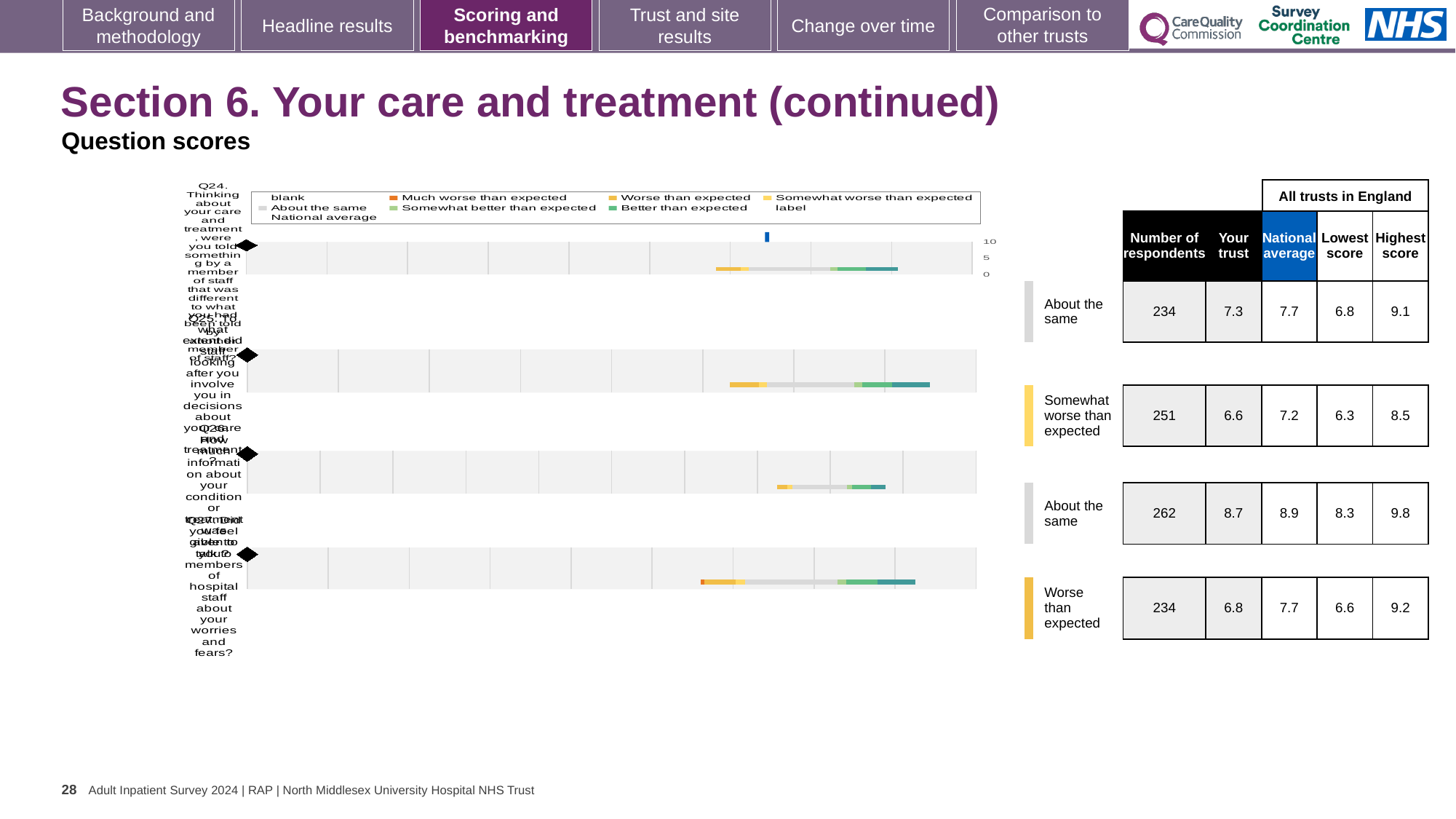
For the fourth question row (Q27), what is the highest score among all trusts in England? 9.2 Which legend entry is shown in dark orange? Much worse than expected What kind of chart is used to show the question scores on this slide? bar chart Which question row has the highest 'Your trust' score in the table? Q26 (third row), 8.7 What benchmark category is the fourth question row (Q27) assigned? Worse than expected For the first question row (Q24), what is the 'Your trust' score shown in the table? 7.3 What is the difference between the national average and 'Your trust' score for the fourth question row (Q27)? 0.9 For the second question row (Q25), what is the national average shown in the table? 7.2 For the third question row (Q26), how many respondents are shown in the table? 262 How many question rows (charts) are shown on the slide? 4 Which legend entry is shown in grey? About the same Which question row has the lowest 'Your trust' score in the table? Q25 (second row), 6.6